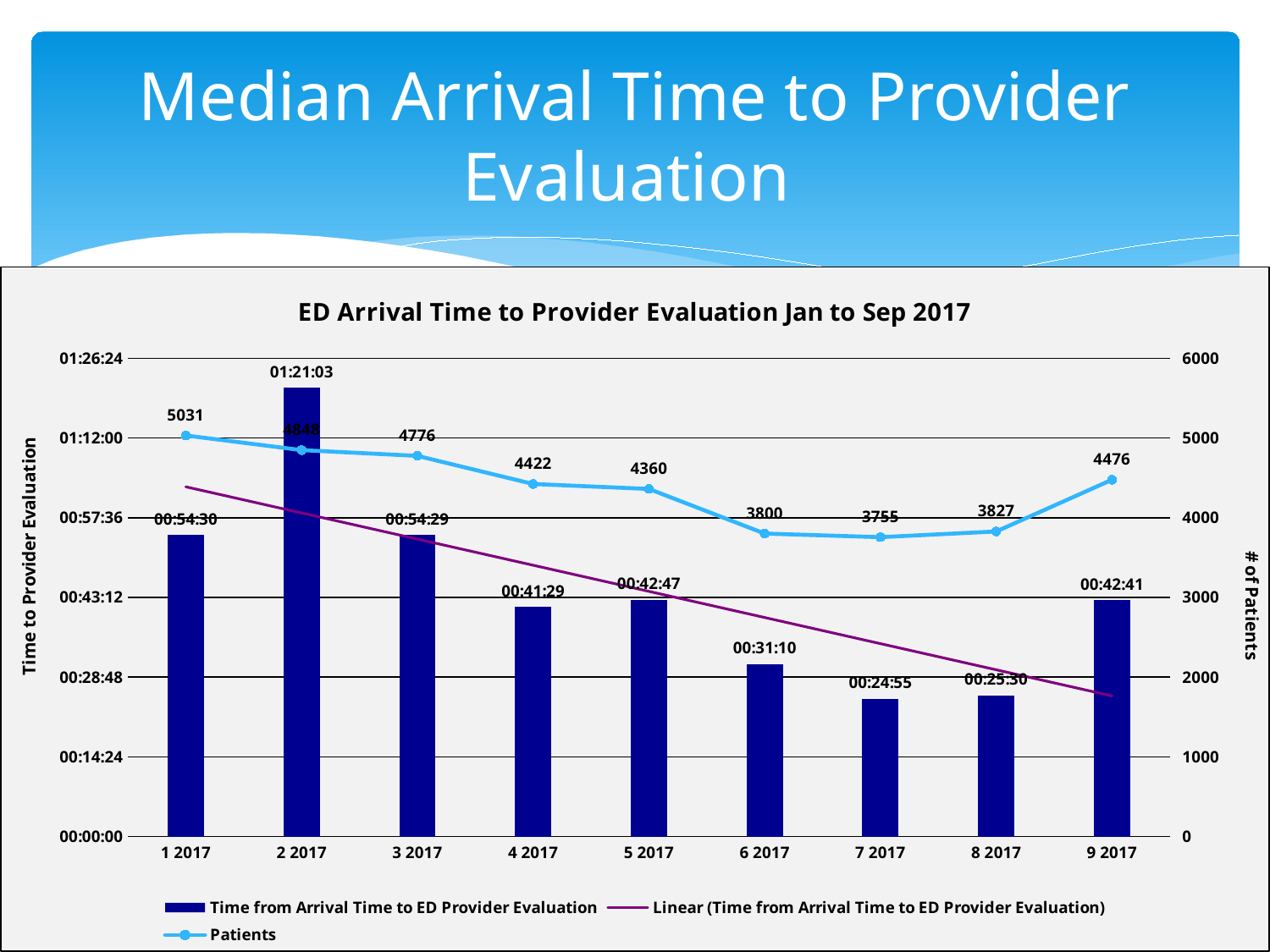
What is the time from arrival to ED provider evaluation for 6 2017? 00:31:10 What is the median time from arrival to ED provider evaluation for 2 2017? 01:21:03 Which has more patients, 6 2017 or 8 2017? 8 2017 Which month has the lowest number of patients? 7 2017 What is the difference in the number of patients between 1 2017 and 9 2017? 555 How many months are shown on the x axis? 9 Does the Patients line rise or fall from 1 2017 to 7 2017? fall How many series does the legend list? 3 Which month has the highest number of patients? 1 2017 Which month has the highest median time from arrival to ED provider evaluation? 2 2017 How many patients are shown for 9 2017? 4476 Which month has the lowest median time from arrival to ED provider evaluation? 7 2017